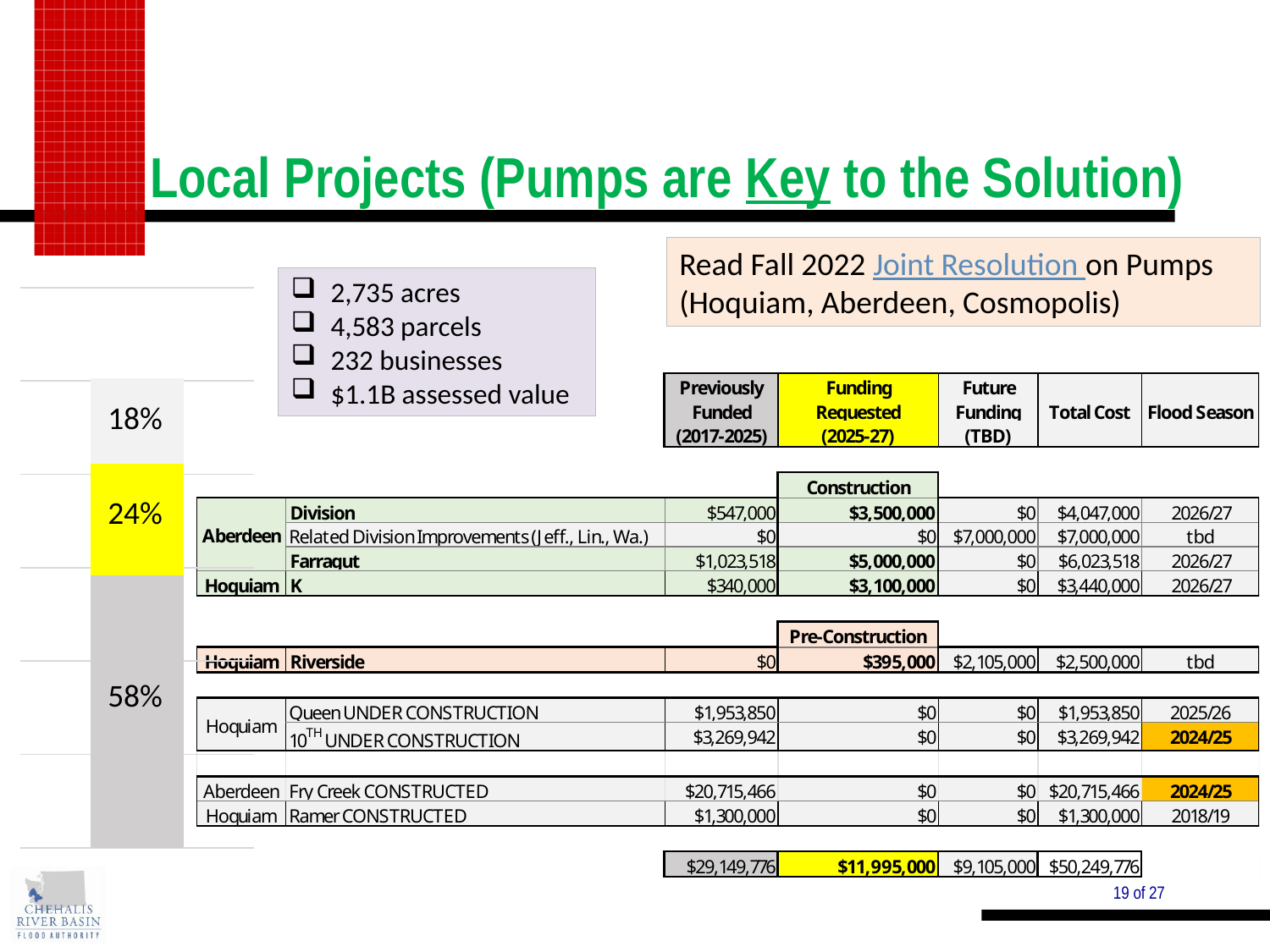
What colour is the segment labelled 24% in the stacked bar? yellow Which is larger in the stacked bar, the yellow segment or the gray segment? gray segment What value is printed on the yellow segment of the stacked bar? 24% What kind of chart is shown on the left side of the slide? stacked bar chart How many segments does the stacked bar on the left of the slide have? 3 Which segment of the stacked bar has the largest value? 58% What value is printed on the top segment of the stacked bar? 18% Which segment of the stacked bar has the smallest value? 18% What is the difference between the yellow segment (24%) and the top segment (18%) of the stacked bar? 6% What is the difference between the gray segment (58%) and the yellow segment (24%) of the stacked bar? 34% What is the total of the three segments in the stacked bar? 100% What value is printed on the gray segment of the stacked bar? 58%